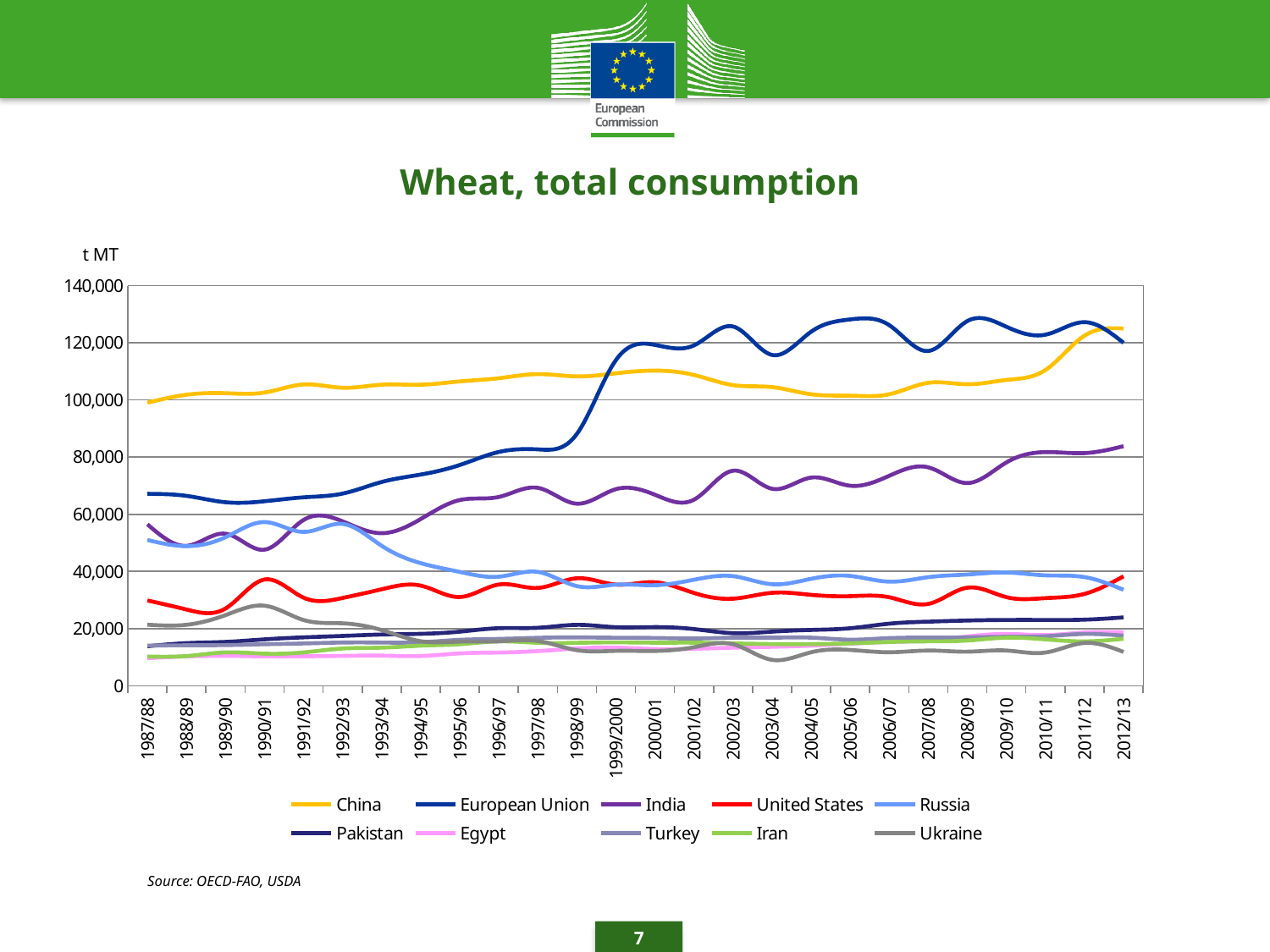
How many series does the legend list? 10 What unit is shown on the y axis? t MT In 1987/88, which is higher, Russia or the United States? Russia Is the value for China in 1987/88 greater or less than 80,000? greater How many marketing years are shown along the x axis? 26 Which series has the lowest value in 2012/13? Ukraine In 1987/88, which is higher, China or the European Union? China Is the value for the European Union in 2012/13 greater or less than 100,000? greater What kind of chart is shown on the slide? line chart Is the value for Pakistan in 2012/13 greater or less than 40,000? less Which series has the highest value in 2005/06? European Union Does the value for Russia rise or fall overall from 1987/88 to 2012/13? fall